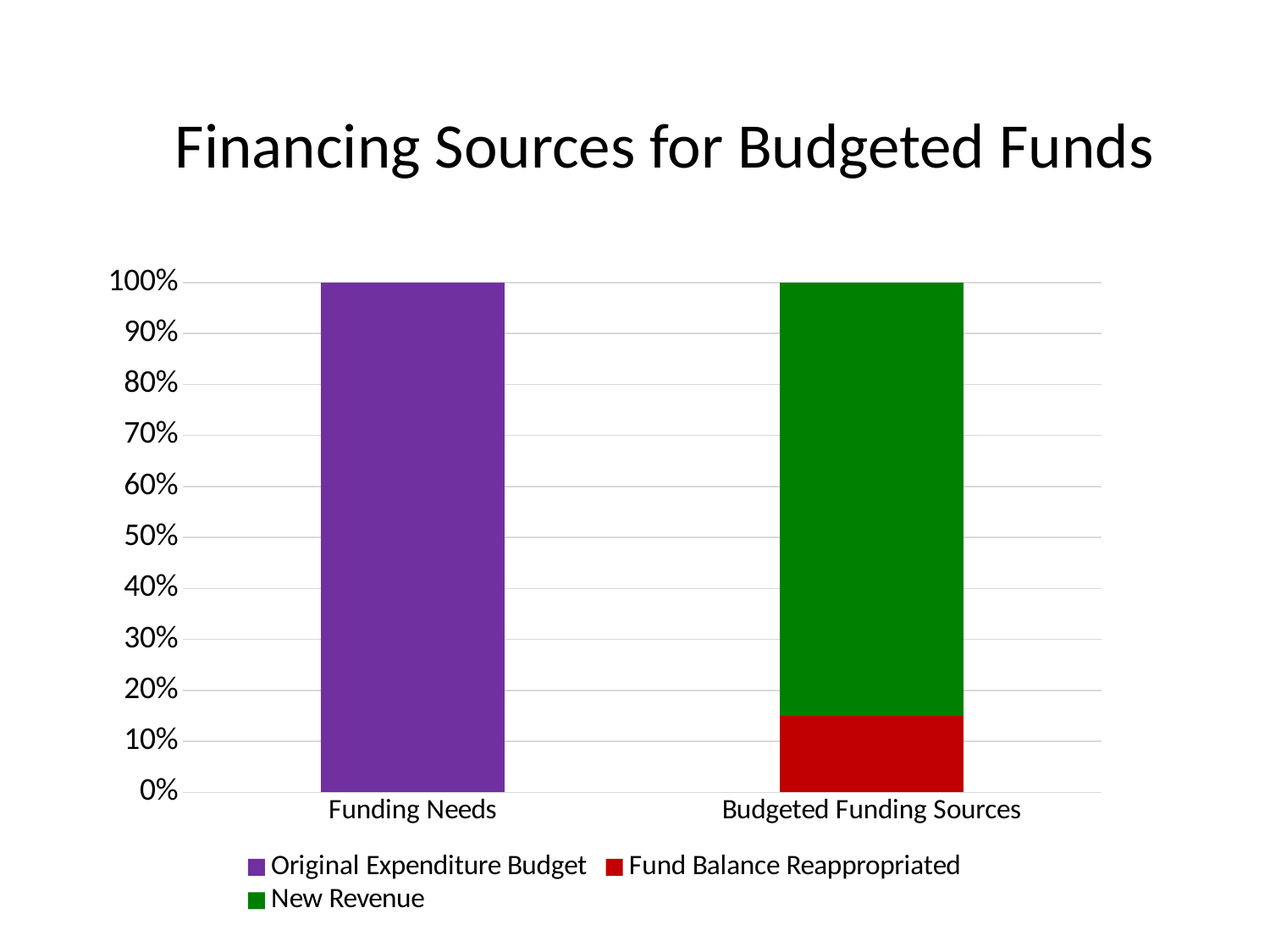
Which series is shown in the Funding Needs bar? Original Expenditure Budget What is the title of the chart? Financing Sources for Budgeted Funds What value does the Original Expenditure Budget bar for Funding Needs reach? 100% Which series is the smallest segment in the Budgeted Funding Sources bar? Fund Balance Reappropriated In the Budgeted Funding Sources bar, which is larger: New Revenue or Fund Balance Reappropriated? New Revenue Is the Fund Balance Reappropriated value for Budgeted Funding Sources greater or less than 10%? greater What kind of chart is shown on the slide? Stacked bar chart How many series does the legend list? 3 How many categories are shown on the x axis? 2 Is the Fund Balance Reappropriated value for Budgeted Funding Sources greater or less than 20%? less What is the total height of the stacked bar for Budgeted Funding Sources? 100% Is the New Revenue portion of the Budgeted Funding Sources bar greater or less than 80%? greater